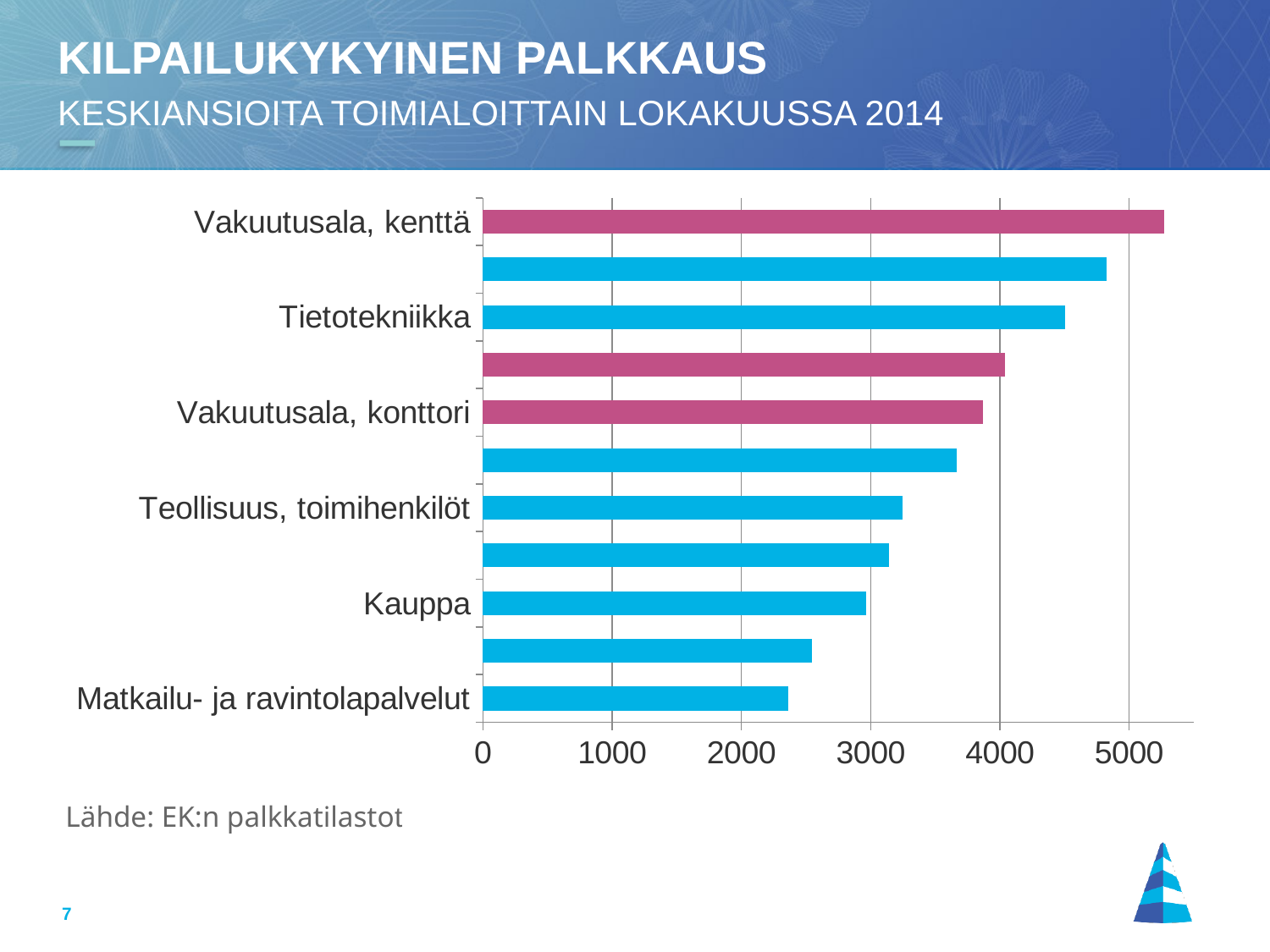
Is the value for Vakuutusala, konttori greater or less than 4000? less Which labelled category has the highest value? Vakuutusala, kenttä How many bars are plotted in the chart? 11 What kind of chart is shown on the slide? Bar chart Is the value for Vakuutusala, kenttä greater or less than 5000? greater Is the value for Tietotekniikka greater or less than 4000? greater Which is larger, the value for Tietotekniikka or the value for Vakuutusala, konttori? Tietotekniikka What is the subtitle of the slide above the chart? KESKIANSIOITA TOIMIALOITTAIN LOKAKUUSSA 2014 Which labelled category has the lowest value? Matkailu- ja ravintolapalvelut